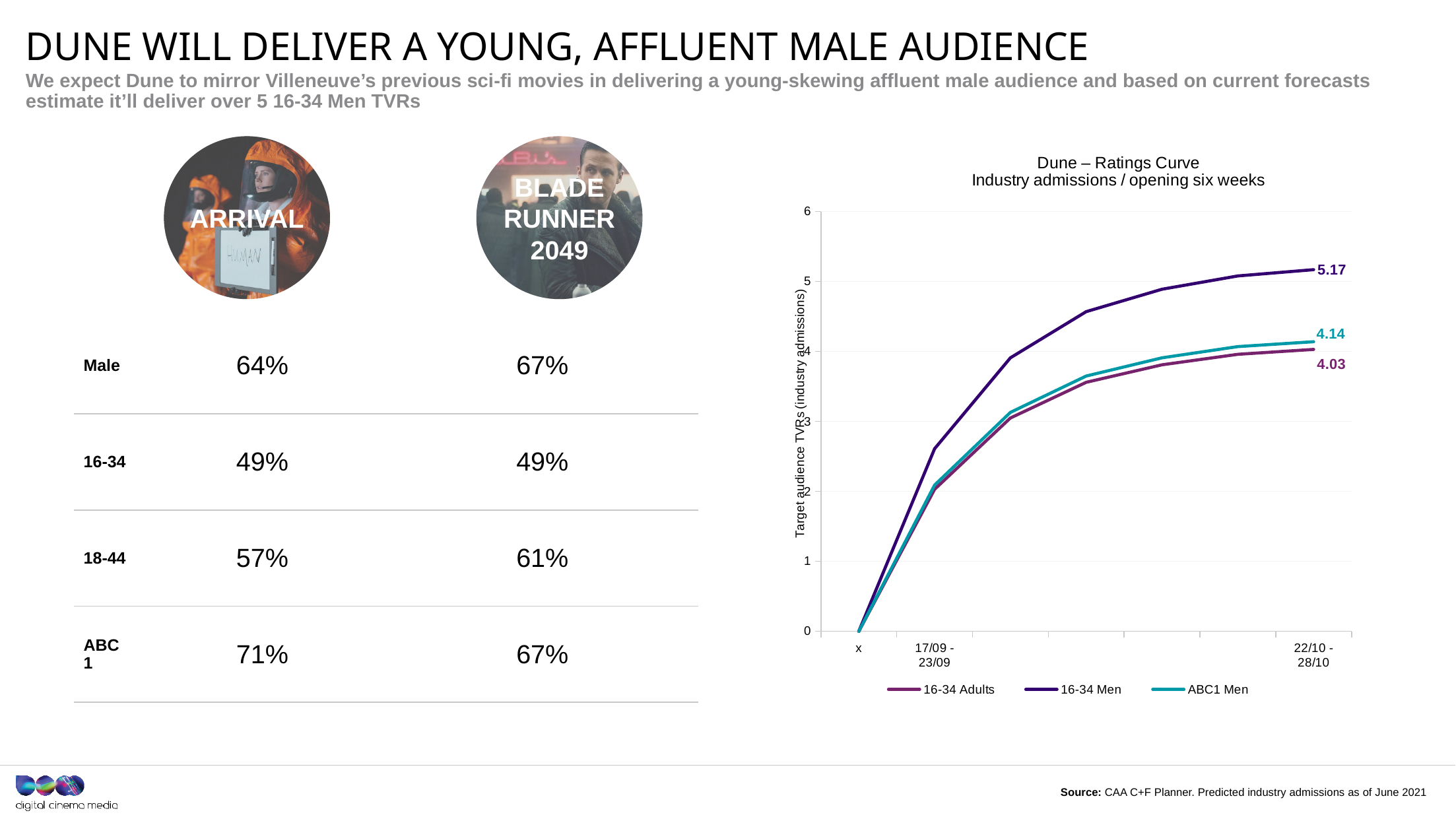
What is the difference between the final values of ABC1 Men and 16-34 Adults? 0.11 Which series has the lowest final labelled value? 16-34 Adults What is the final labelled value for the ABC1 Men series? 4.14 What kind of chart is shown on the slide? Line chart What is the title of the chart? Dune – Ratings Curve Industry admissions / opening six weeks Which series reaches the highest value at the end of the six weeks? 16-34 Men Is the value for 16-34 Men in the week 17/09 - 23/09 greater or less than 2? greater What is the final labelled value for the 16-34 Adults series? 4.03 How many series does the legend list? 3 Do the values rise or fall along the x axis? Rise What is the final labelled value for the 16-34 Men series? 5.17 What is the difference between the final values of 16-34 Men and ABC1 Men? 1.03